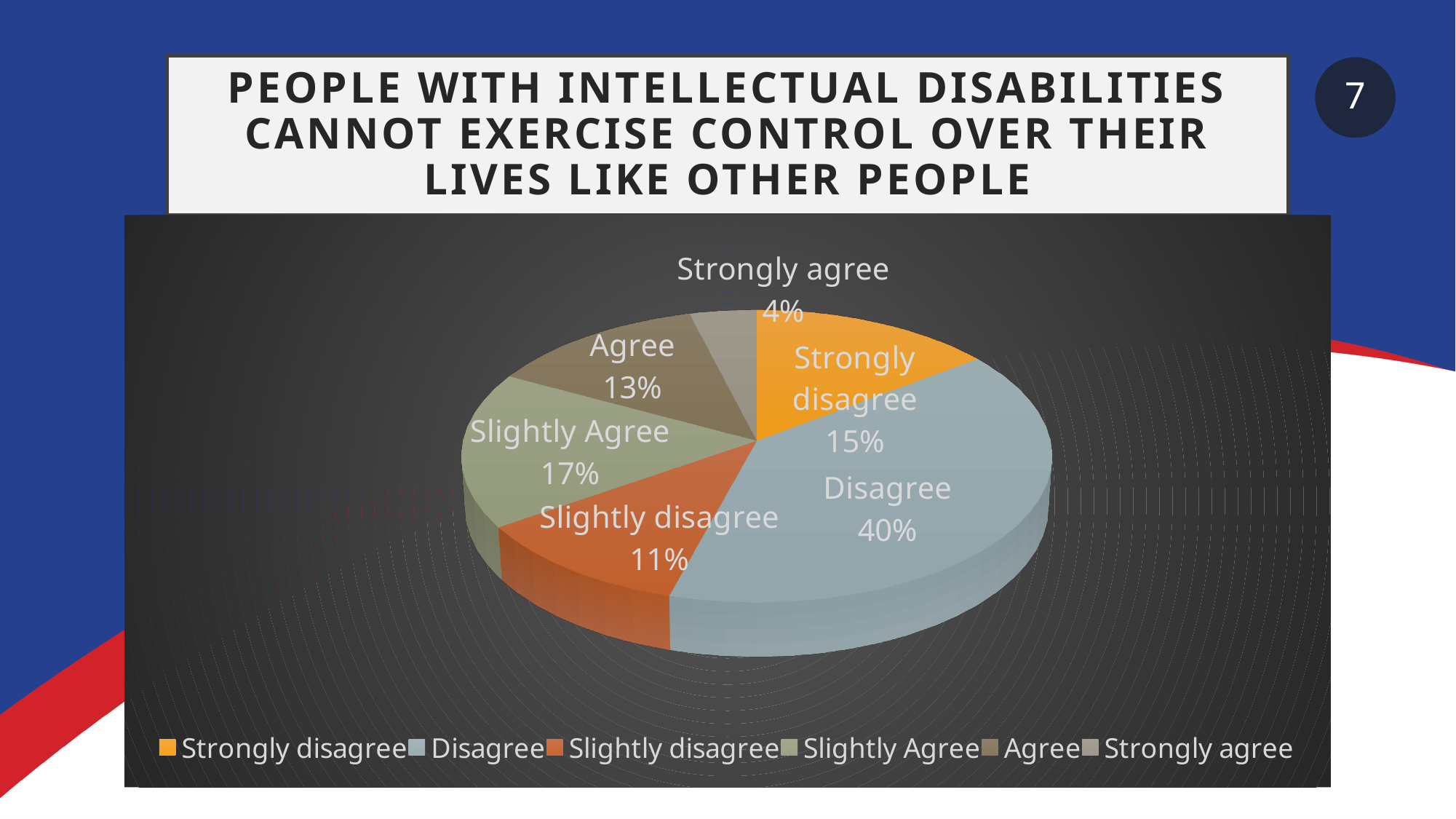
Which is larger, the share for "Slightly Agree" or the share for "Slightly disagree"? Slightly Agree What kind of chart is shown on the slide? Pie chart What percentage of respondents chose "Agree"? 13% What is the combined share of "Strongly disagree" and "Disagree"? 55% What percentage of respondents chose "Strongly agree"? 4% What is the difference in percentage points between "Disagree" and "Strongly disagree"? 25 Which response category has the smallest share of the pie? Strongly agree Which colour represents "Strongly disagree" in the legend? Orange What percentage of respondents chose "Slightly Agree"? 17% What percentage of respondents chose "Disagree"? 40% Which response category has the largest share of the pie? Disagree How many response categories are shown in the pie chart? 6